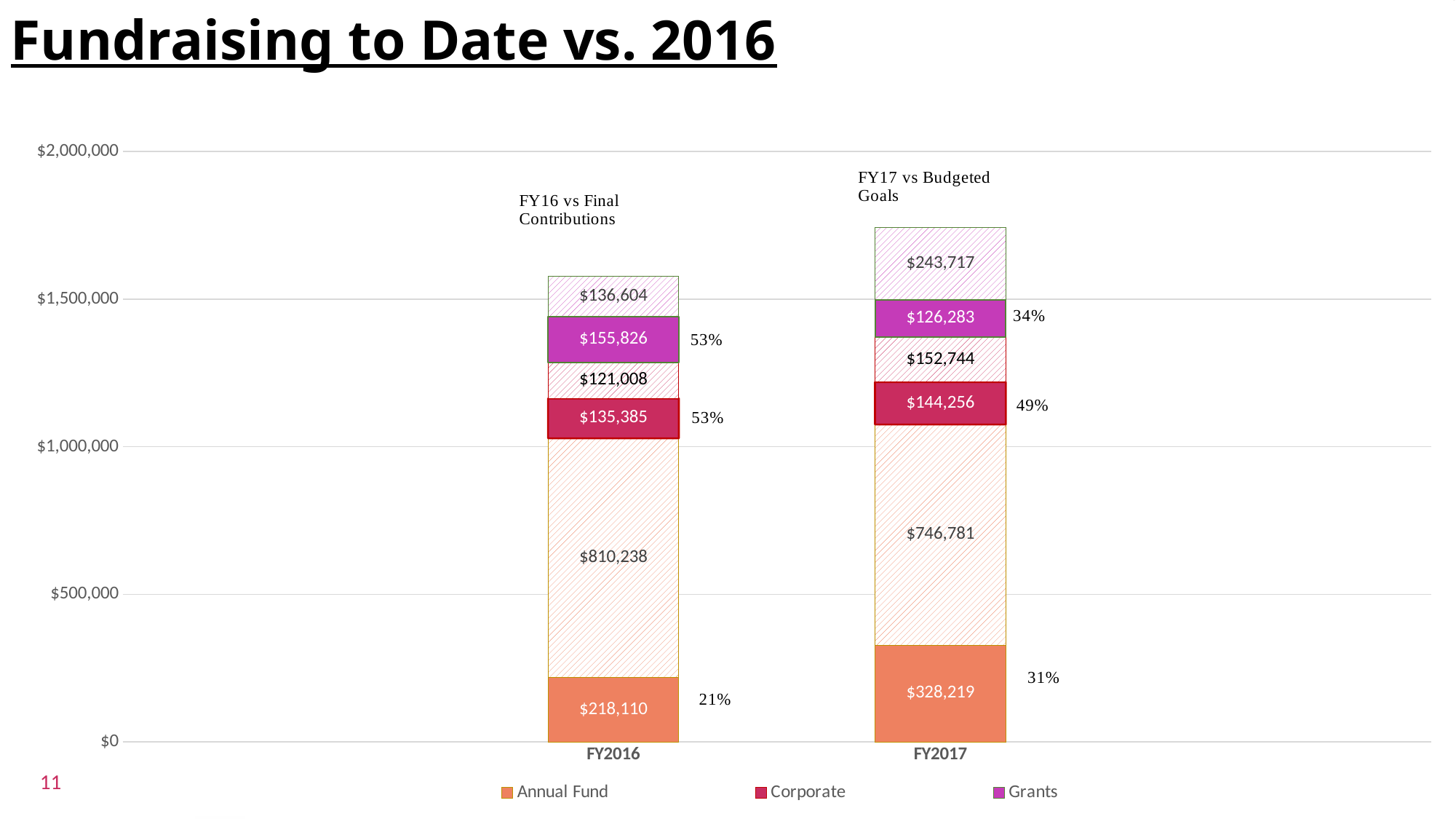
What is the difference between the solid Annual Fund segments for FY2017 and FY2016? $110,109 How many series does the legend list? 3 What is the value of the hatched segment directly above the solid Annual Fund segment for FY2017? $746,781 Which year has the larger solid Grants segment, FY2016 or FY2017? FY2016 What type of chart is shown on the slide? stacked bar chart What is the value of the solid Annual Fund segment for FY2017? $328,219 What is the value of the solid Annual Fund segment for FY2016? $218,110 Is the total height of the FY2017 bar greater or less than $1,500,000? greater How many categories are shown on the x axis? 2 What percentage label is shown next to the Annual Fund segment for FY2016? 21% What is the value of the solid Grants segment for FY2016? $155,826 What is the value of the solid Corporate segment for FY2017? $144,256